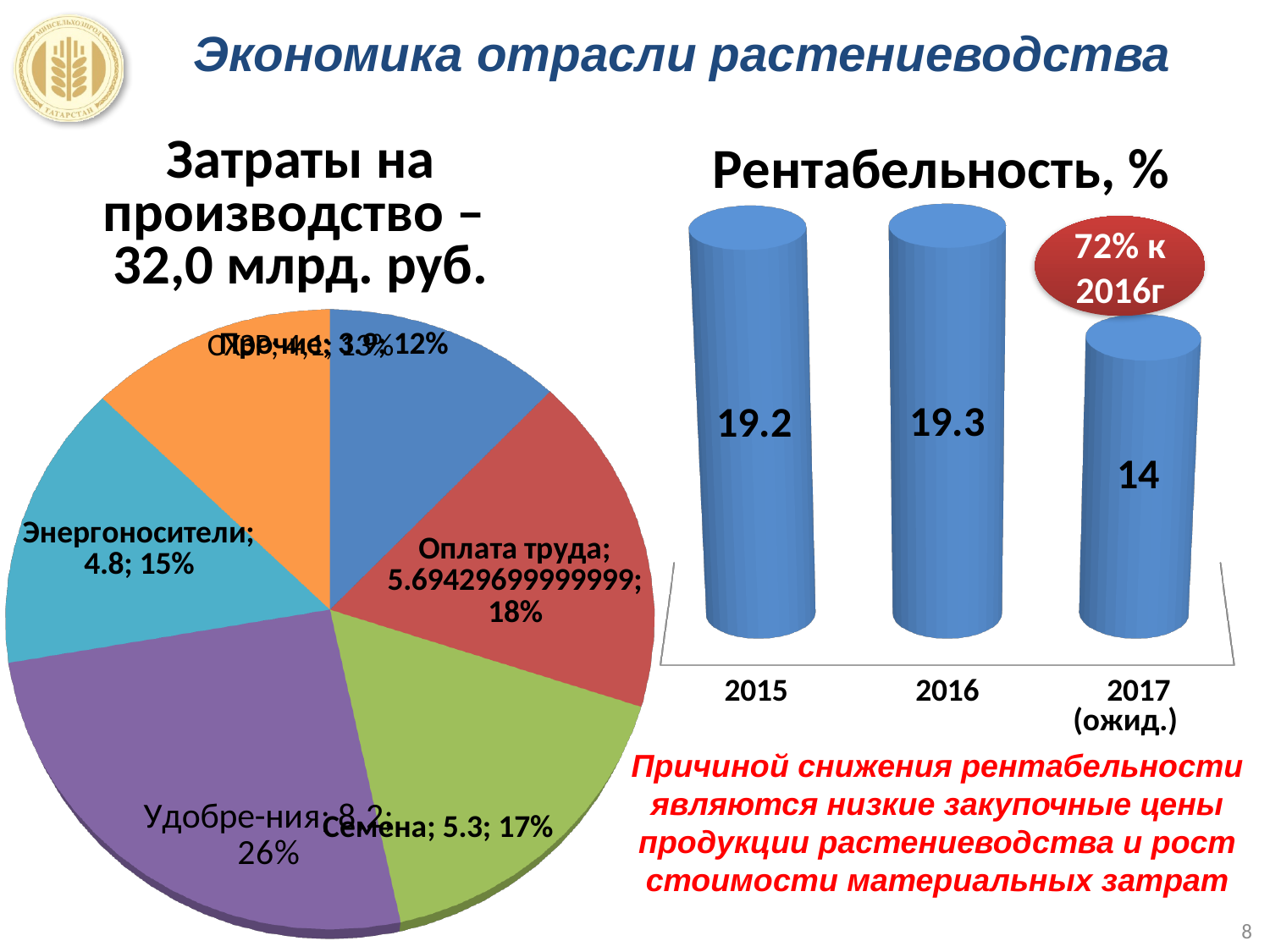
In the pie chart on the left, what is the value shown for 'Семена'? 5.3 In the pie chart on the left, what share does 'Удобрения' have? 26% In the chart titled 'Рентабельность, %', how many bars are plotted? 3 In the chart titled 'Рентабельность, %', what is the value for 2015? 19.2 What kind of chart is the one on the left of the slide? pie chart In the chart titled 'Рентабельность, %', which year has the lowest value? 2017 (ожид.) In the pie chart on the left, which is larger, the value for 'Семена' or for 'Энергоносители'? Семена What kind of chart is the one titled 'Рентабельность, %'? bar chart In the chart titled 'Рентабельность, %', what is the difference between the values for 2016 and 2017 (ожид.)? 5.3 In the pie chart on the left, which category has the largest slice? Удобрения In the chart titled 'Рентабельность, %', what is the value for 2017 (ожид.)? 14 In the chart titled 'Рентабельность, %', do the values rise or fall from 2016 to 2017 (ожид.)? fall